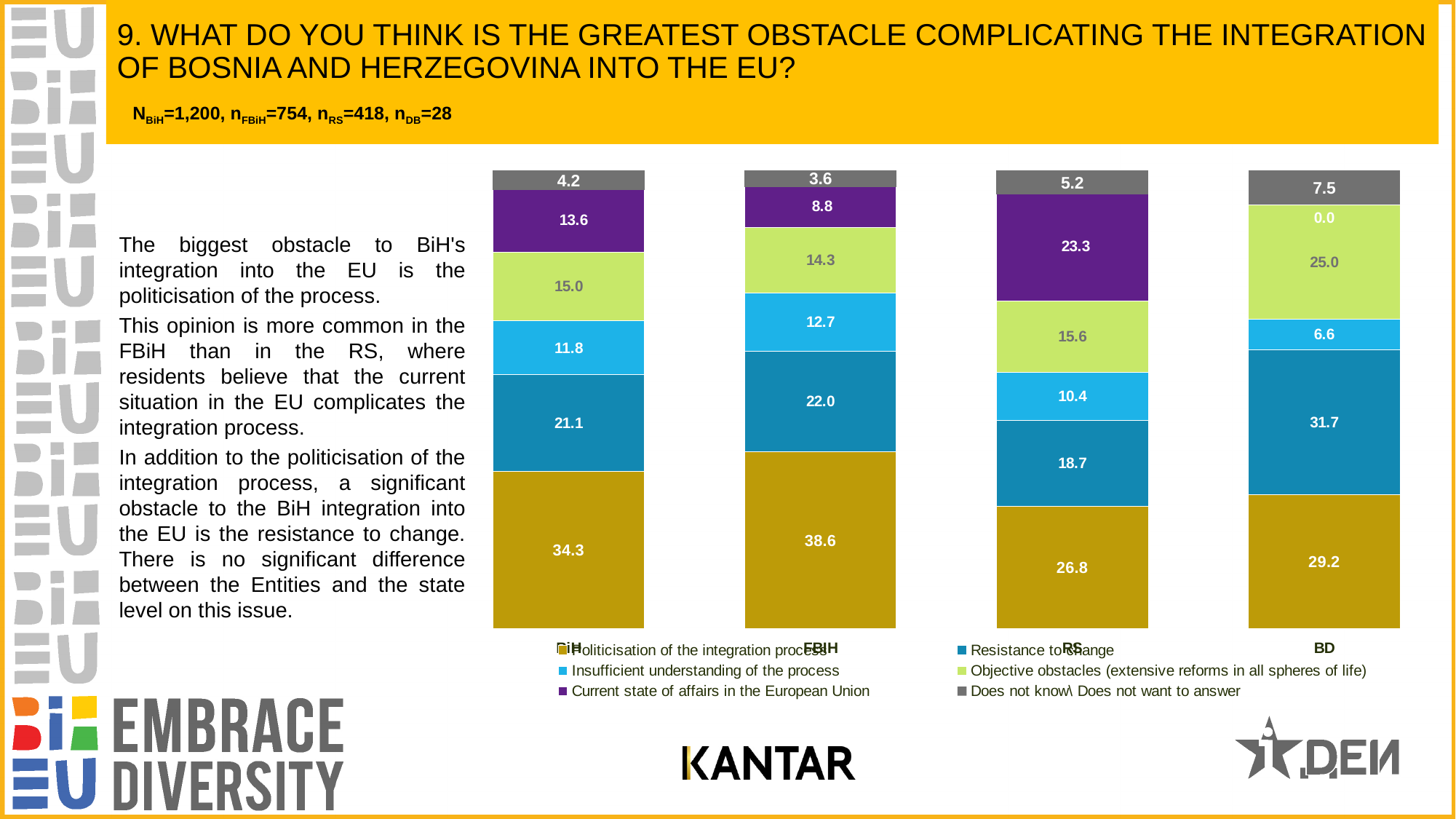
Which category has the highest value for Politicisation of the integration process? FBiH What kind of chart is shown on the slide? Stacked bar chart What is the value for Resistance to change in BD? 31.7 Which category has the lowest value for Insufficient understanding of the process? BD How many categories are shown on the x axis? 4 What is the total of the stacked bar for BD? 100.0 Is the value for Objective obstacles larger in BD or in RS? BD What is the value for Does not know\ Does not want to answer in BiH? 4.2 How many series does the legend list? 6 What is the value for Current state of affairs in the European Union in RS? 23.3 What is the value for Politicisation of the integration process in FBiH? 38.6 What is the difference between the Politicisation of the integration process values for FBiH and RS? 11.8